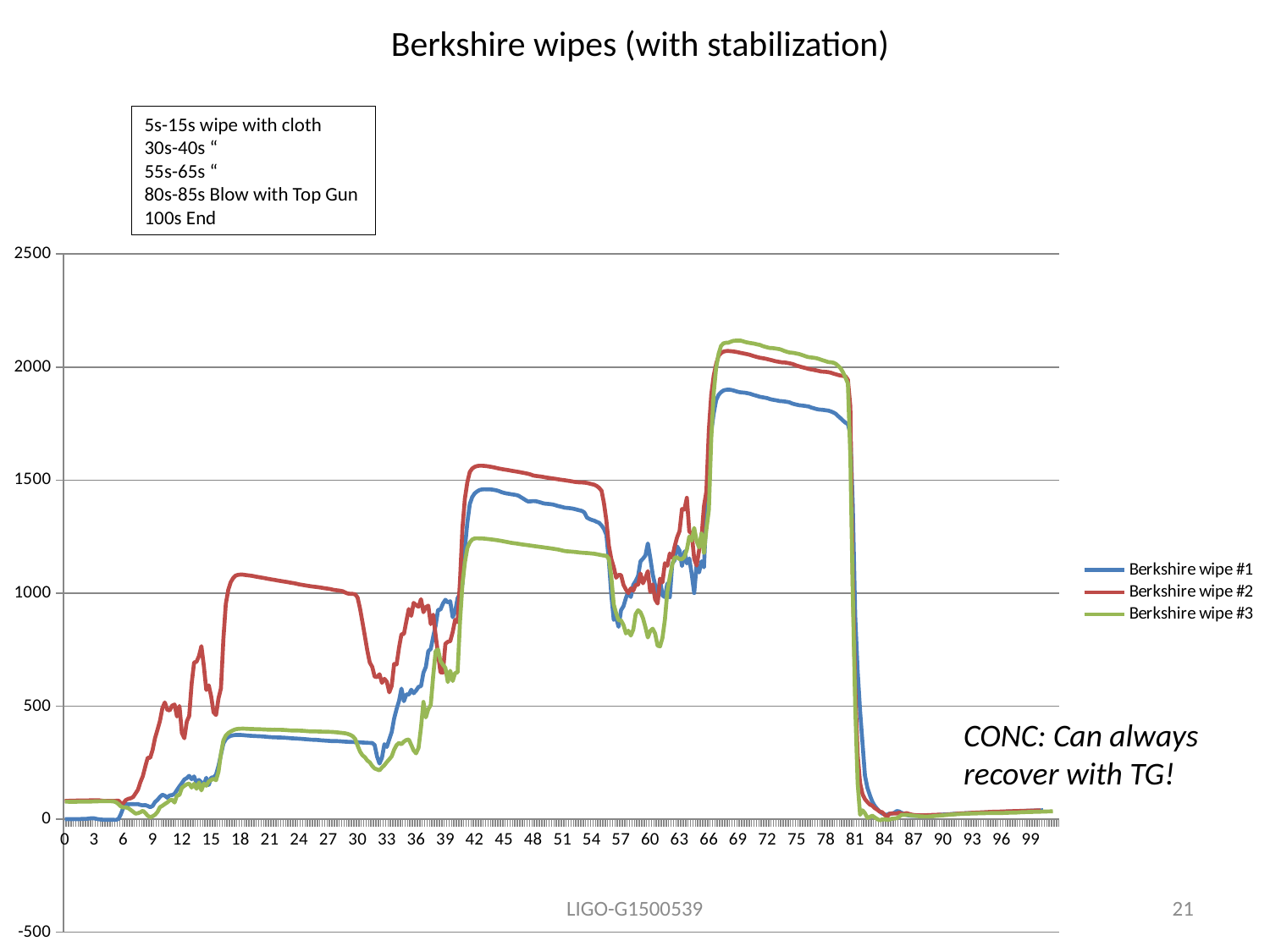
At x = 69, which series has the higher value, Berkshire wipe #1 or Berkshire wipe #3? Berkshire wipe #3 Which series is drawn in green according to the legend? Berkshire wipe #3 How many series does the legend list? 3 What is the title of the chart? Berkshire wipes (with stabilization) What kind of chart is shown on the slide? line chart Is the value for Berkshire wipe #3 at x = 69 greater or less than 2000? greater Do the values for Berkshire wipe #2 rise or fall between x = 81 and x = 84? fall Is the value for Berkshire wipe #3 at x = 90 greater or less than 500? less At x = 18, which series has the higher value, Berkshire wipe #1 or Berkshire wipe #2? Berkshire wipe #2 Is the value for Berkshire wipe #1 at x = 18 greater or less than 500? less